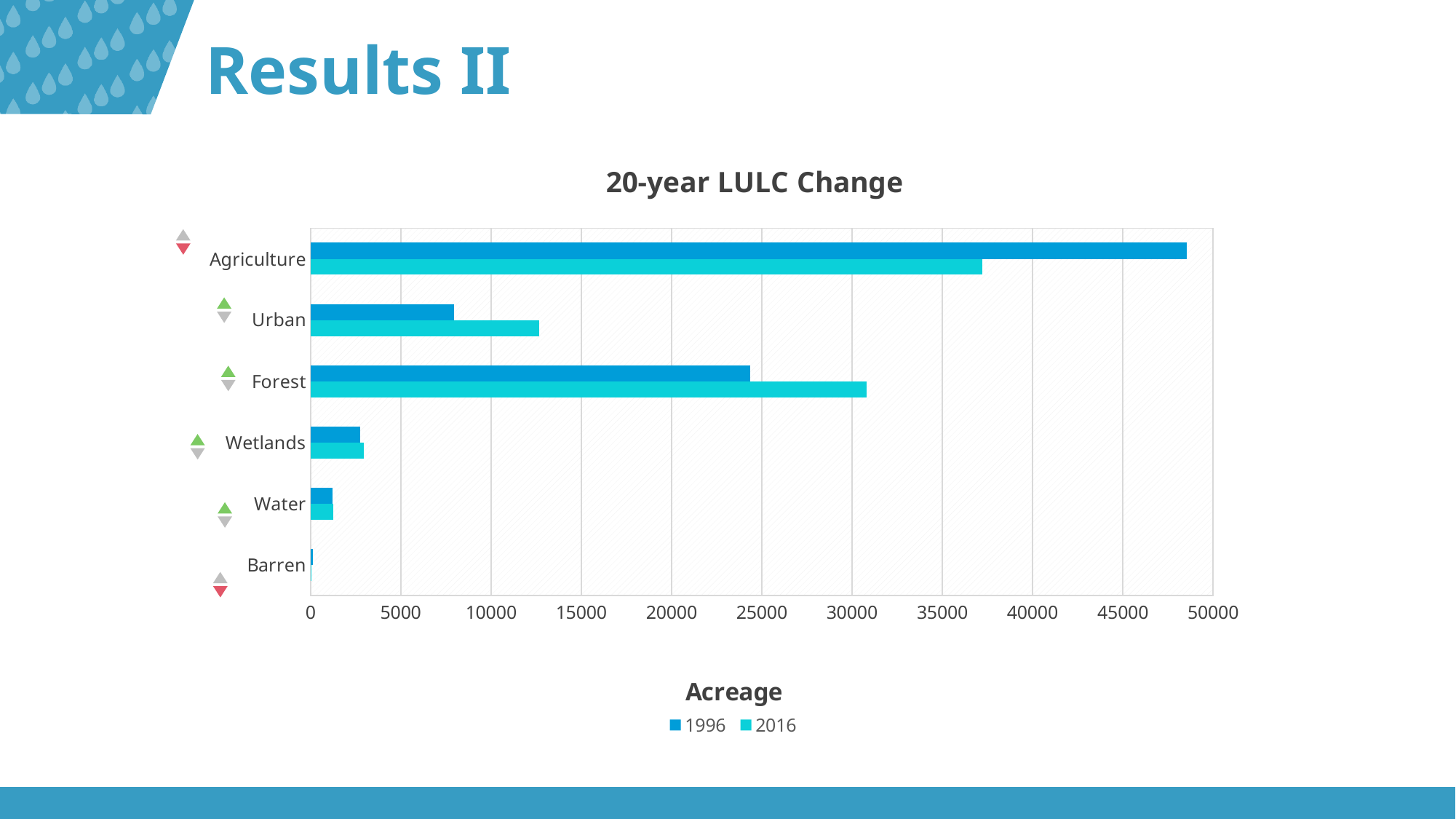
Is the 1996 acreage for Urban greater or less than 10000? less What kind of chart is shown on the slide? bar chart Which category has the highest acreage in 1996? Agriculture For Forest, which year has the larger acreage, 1996 or 2016? 2016 How many land-use categories are plotted on the chart? 6 How many series does the legend list? 2 What is the title of the chart? 20-year LULC Change Is the 2016 acreage for Agriculture greater or less than 35000? greater Which category has the lowest acreage in 2016? Barren Is the 1996 acreage for Agriculture greater or less than 45000? greater Which two series are listed in the legend? 1996 and 2016 For Agriculture, which year has the larger acreage, 1996 or 2016? 1996